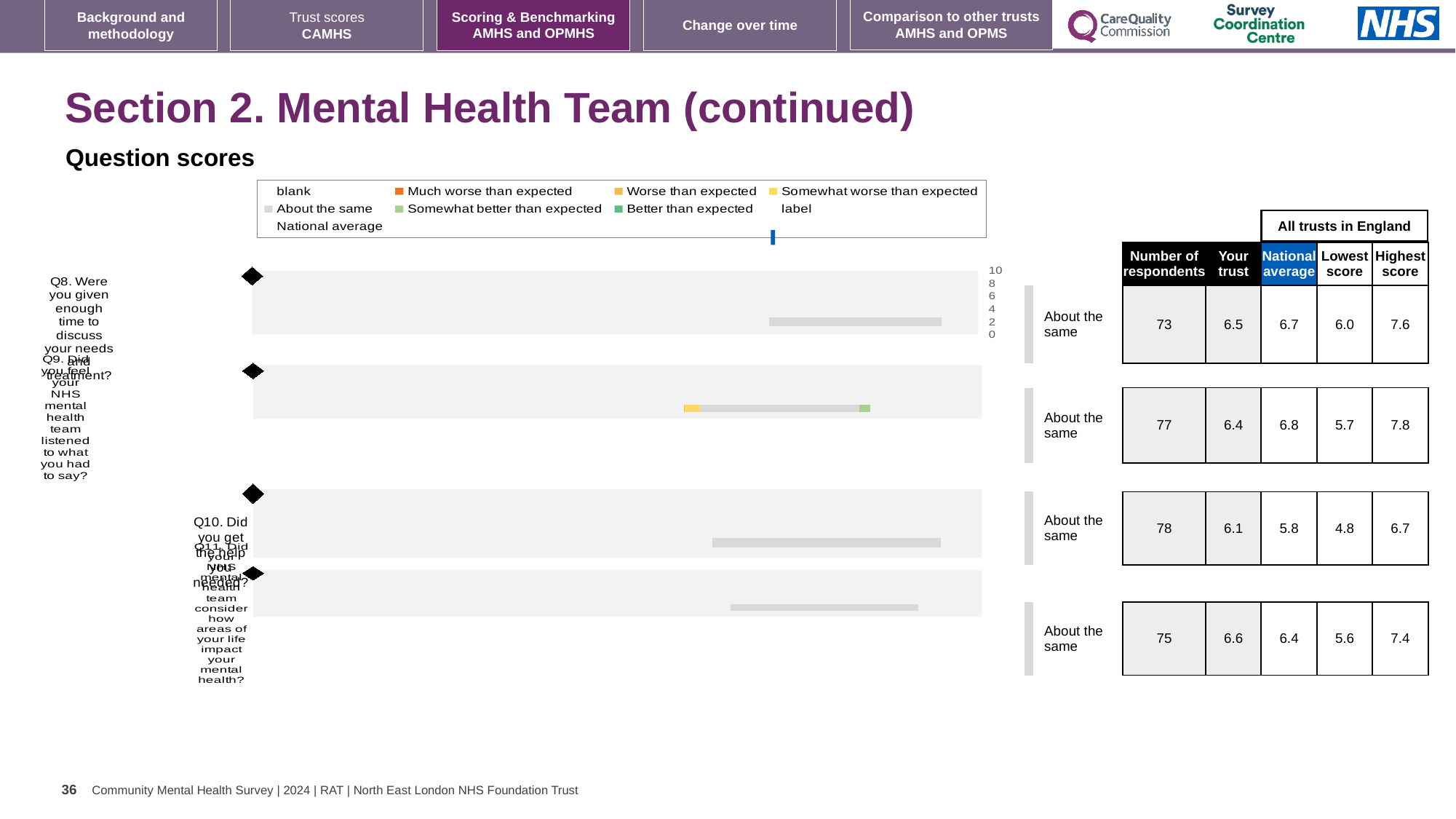
In the table beside the 'Question scores' chart, what is the national average for Q9 (Did you feel your NHS mental health team listened to what you had to say?)? 6.8 How many entries does the legend of the 'Question scores' chart list? 9 What kind of chart is shown under the heading 'Question scores'? bar chart In the table beside the 'Question scores' chart, what is the number of respondents for Q10 (Did you get the help you needed?)? 78 In the table beside the 'Question scores' chart, what is the difference between the highest score and the lowest score for Q9? 2.1 In the legend of the 'Question scores' chart, which colour represents 'Much worse than expected'? orange In the table beside the 'Question scores' chart, which question has the lowest 'Lowest score' value? Q10 In the table beside the 'Question scores' chart, is the 'Your trust' score for Q10 larger or smaller than its national average? larger How many questions (categories) are plotted in the 'Question scores' chart? 4 In the table beside the 'Question scores' chart, which question has the highest 'Your trust' score? Q11 In the table beside the 'Question scores' chart, what is the 'Your trust' score for Q8 (Were you given enough time to discuss your needs and treatment?)? 6.5 In the table beside the 'Question scores' chart, what is the highest score for Q11 (Did your NHS mental health team consider how areas of your life impact your mental health?)? 7.4